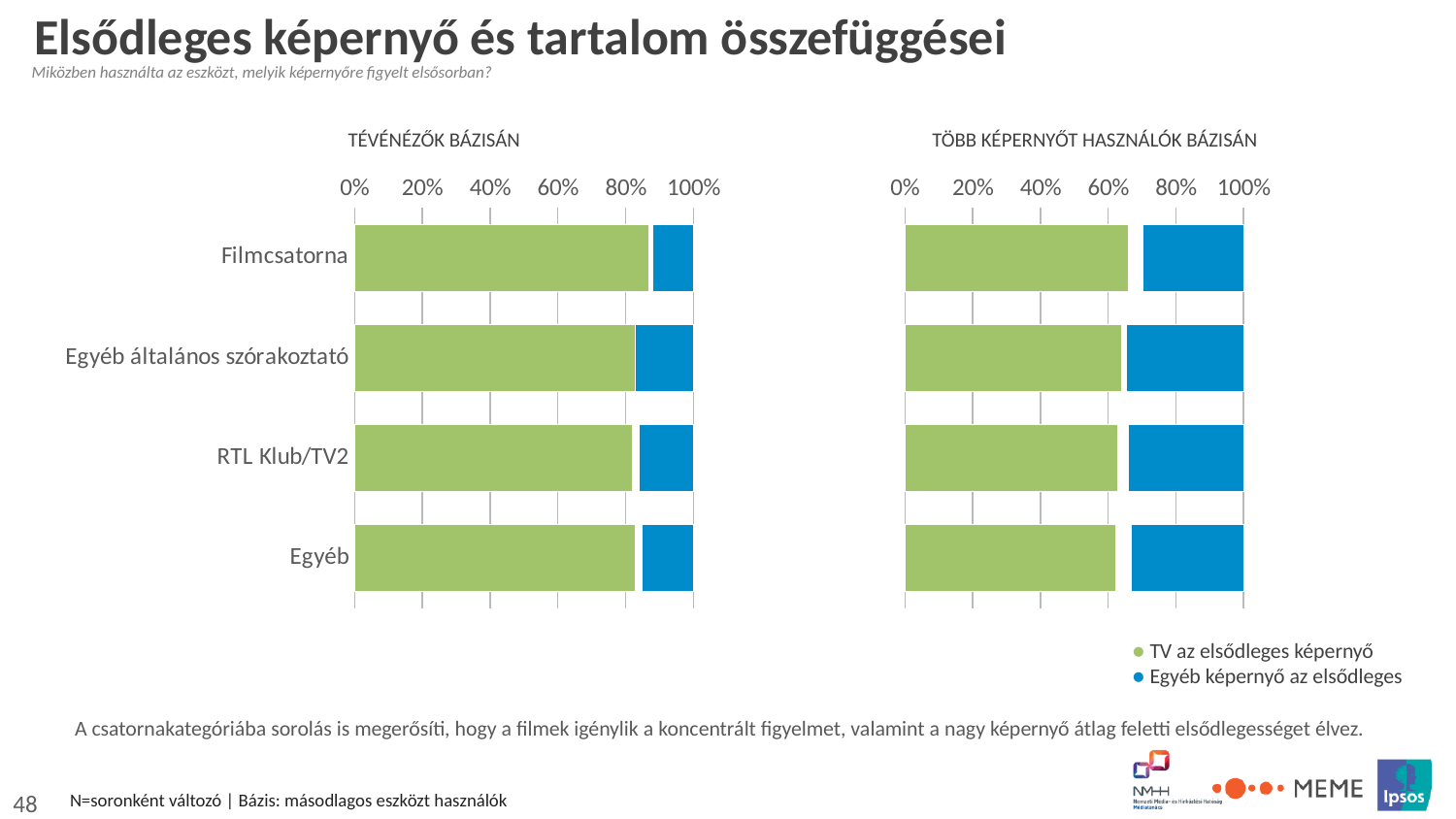
On the left chart (TÉVÉNÉZŐK BÁZISÁN), which category has the highest share for TV az elsődleges képernyő? Filmcsatorna Which colour represents the series TV az elsődleges képernyő in the legend? green On the left chart (TÉVÉNÉZŐK BÁZISÁN), is the value of TV az elsődleges képernyő for Filmcsatorna greater or less than 80%? greater On the right chart (TÖBB KÉPERNYŐT HASZNÁLÓK BÁZISÁN), is the value of TV az elsődleges képernyő for Filmcsatorna greater or less than 60%? greater How many series does the legend list for the charts on this slide? 2 On the right chart (TÖBB KÉPERNYŐT HASZNÁLÓK BÁZISÁN), is the value of Egyéb képernyő az elsődleges for Filmcsatorna greater or less than 20%? greater What kind of chart is the left chart titled TÉVÉNÉZŐK BÁZISÁN? bar chart What is the title of the right chart? TÖBB KÉPERNYŐT HASZNÁLÓK BÁZISÁN On the left chart (TÉVÉNÉZŐK BÁZISÁN), which is larger for TV az elsődleges képernyő: Filmcsatorna or RTL Klub/TV2? Filmcsatorna How many categories are shown on the left chart (TÉVÉNÉZŐK BÁZISÁN)? 4 For Filmcsatorna, is the TV az elsődleges képernyő share larger on the left chart (TÉVÉNÉZŐK BÁZISÁN) or on the right chart (TÖBB KÉPERNYŐT HASZNÁLÓK BÁZISÁN)? left chart (TÉVÉNÉZŐK BÁZISÁN)